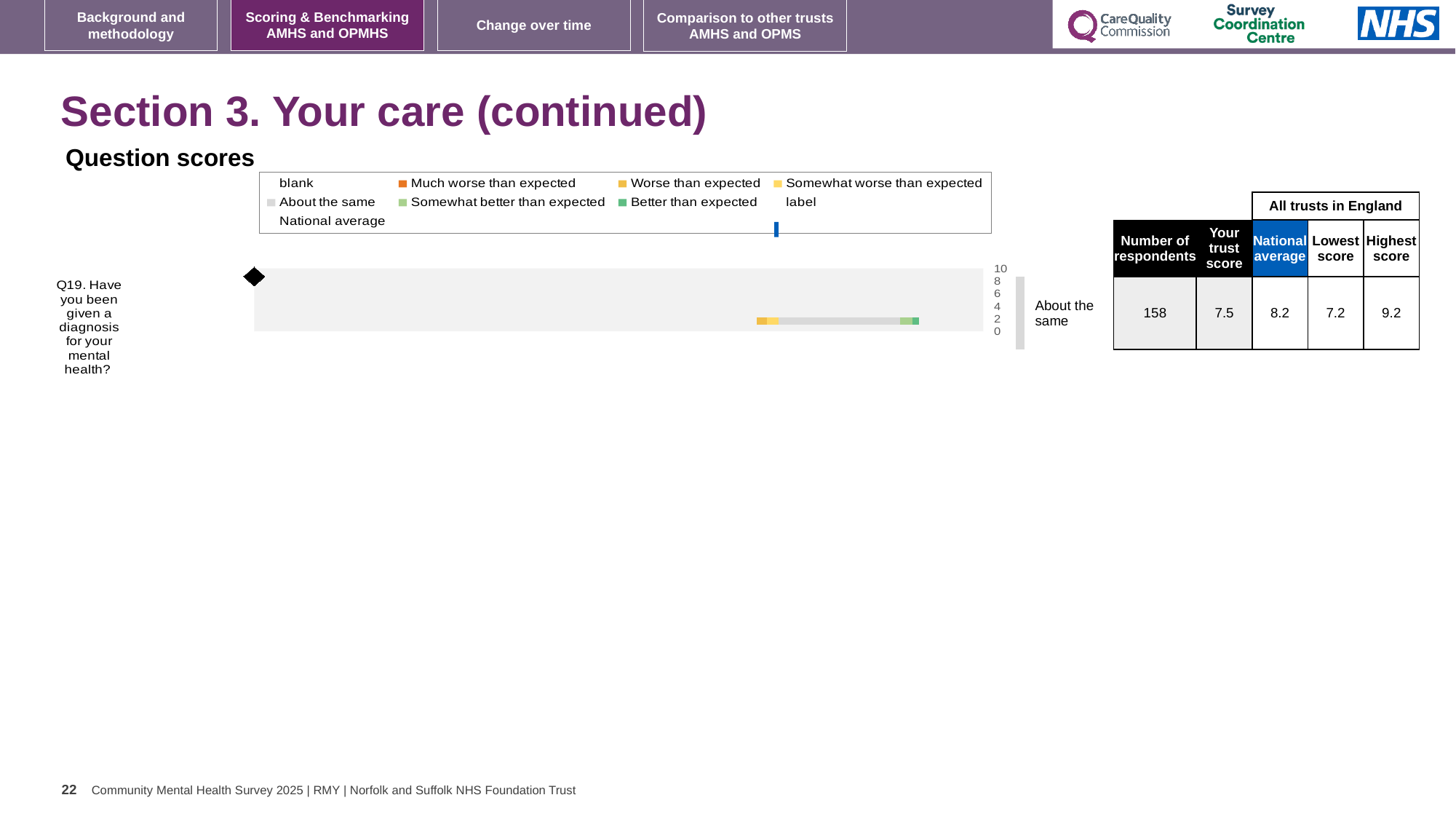
Which survey question is plotted in the Question scores chart? Q19. Have you been given a diagnosis for your mental health? What is the National average score for Q19? 8.2 For Q19, which is larger: the trust score or the National average? National average What is the Highest score among all trusts in England for Q19? 9.2 What is the Lowest score among all trusts in England for Q19? 7.2 What kind of chart is shown under 'Question scores'? bar chart How many respondents answered Q19? 158 For Q19, what is the difference between the Highest score and the Lowest score among all trusts in England? 2.0 What is the 'Your trust score' value for Q19? 7.5 For Q19, how much higher is the National average than the trust score? 0.7 How many survey questions are plotted in the Question scores chart? 1 What benchmark category label is shown next to the bar for Q19? About the same